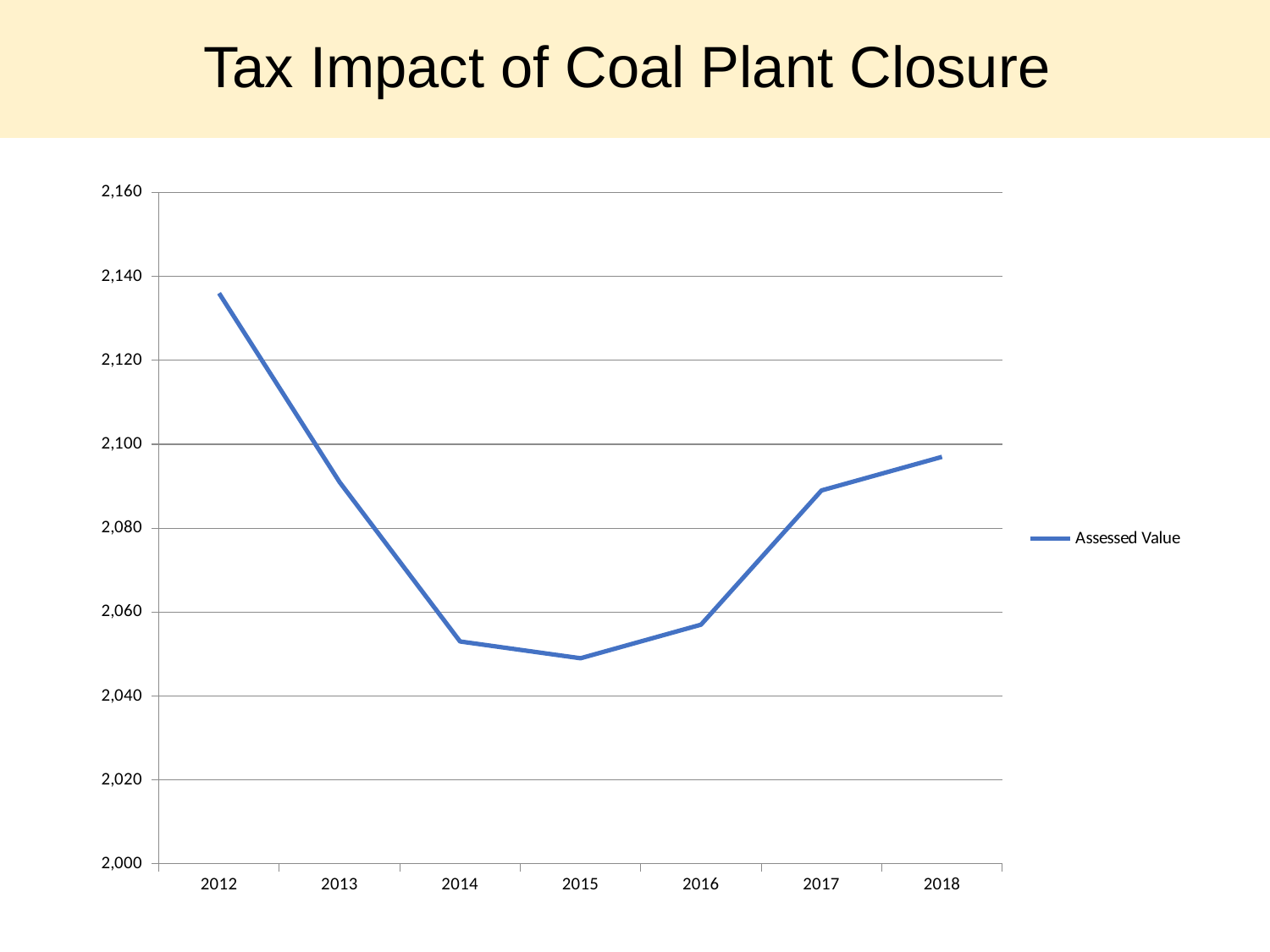
Is the Assessed Value for 2012 greater or less than 2,120? greater Is the Assessed Value for 2017 greater or less than 2,080? greater How many series does the legend list? 1 Which year has the larger Assessed Value, 2012 or 2018? 2012 Which year has the highest Assessed Value? 2012 Which year has the lowest Assessed Value? 2015 What is the name of the series shown in the legend? Assessed Value Is the Assessed Value for 2014 greater or less than 2,060? less Does the Assessed Value rise or fall from 2012 to 2015? fall What kind of chart is shown on the slide? line chart How many years are plotted along the x axis? 7